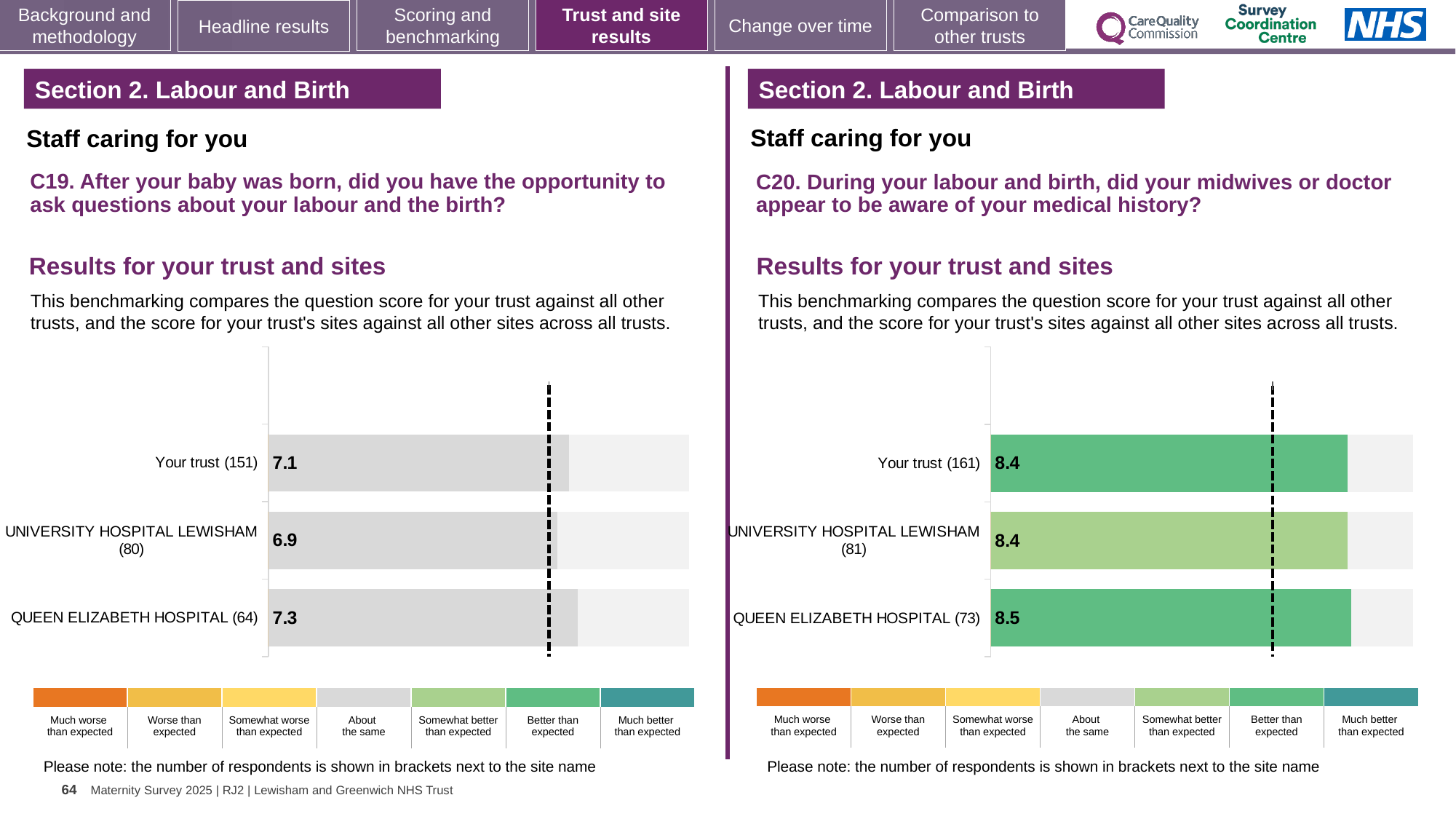
What kind of chart is the C20 chart on the right? Bar chart In the C20 chart on the right, which benchmark category does the colour of the UNIVERSITY HOSPITAL LEWISHAM (81) bar correspond to in the legend? Somewhat better than expected In the C20 chart on the right, which category has the highest score? QUEEN ELIZABETH HOSPITAL (73) In the C19 chart on the left, which category has the lowest score? UNIVERSITY HOSPITAL LEWISHAM (80) In the C20 chart on the right, what is the score for QUEEN ELIZABETH HOSPITAL (73)? 8.5 In the C19 chart on the left, what is the score for Your trust (151)? 7.1 In the C19 chart on the left, what is the score for UNIVERSITY HOSPITAL LEWISHAM (80)? 6.9 In the C19 chart on the left, how many bars are plotted? 3 In the C20 chart on the right, what is the difference between the scores for QUEEN ELIZABETH HOSPITAL (73) and UNIVERSITY HOSPITAL LEWISHAM (81)? 0.1 In the C19 chart on the left, which category has the highest score? QUEEN ELIZABETH HOSPITAL (64) In the C20 chart on the right, what is the score for Your trust (161)? 8.4 In the C19 chart on the left, what is the difference between the scores for QUEEN ELIZABETH HOSPITAL (64) and UNIVERSITY HOSPITAL LEWISHAM (80)? 0.4